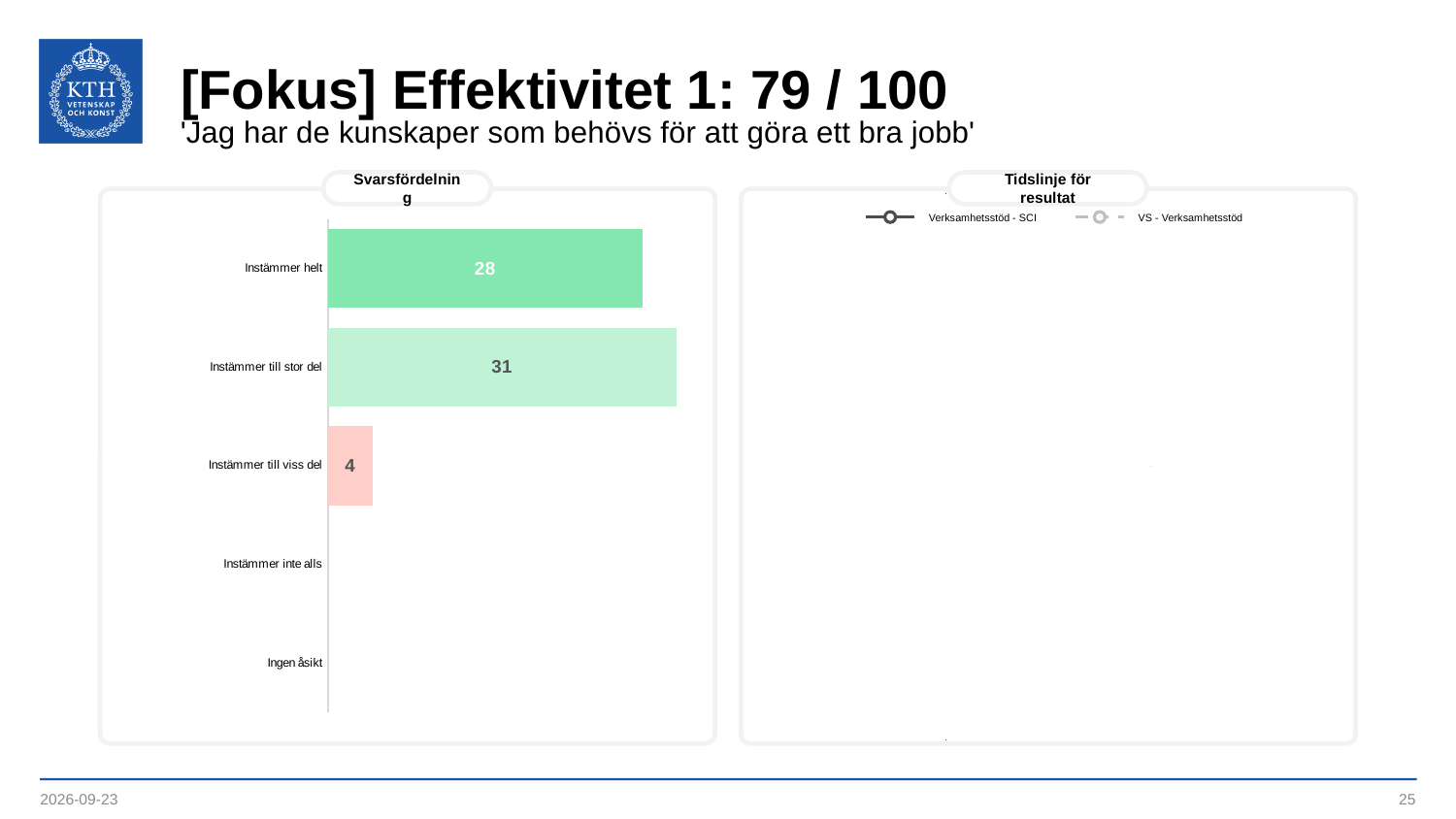
In the 'Svarsfördelning' chart, what is the difference between 'Instämmer helt' and 'Instämmer till viss del'? 24 In the 'Svarsfördelning' chart, what is the value for 'Instämmer till stor del'? 31 In the 'Svarsfördelning' chart, which of the labelled bars has the lowest value? Instämmer till viss del In the 'Svarsfördelning' chart, which is larger: 'Instämmer helt' or 'Instämmer till stor del'? Instämmer till stor del In the 'Svarsfördelning' chart, what is the difference between 'Instämmer till stor del' and 'Instämmer helt'? 3 What kind of chart is the 'Svarsfördelning' chart? Bar chart In the 'Svarsfördelning' chart, what is the value for 'Instämmer till viss del'? 4 What are the two legend entries in the 'Tidslinje för resultat' chart? Verksamhetsstöd - SCI and VS - Verksamhetsstöd How many series does the legend of the 'Tidslinje för resultat' chart list? 2 How many categories are listed on the axis of the 'Svarsfördelning' chart? 5 In the 'Svarsfördelning' chart, what is the value for 'Instämmer helt'? 28 In the 'Svarsfördelning' chart, which category has the highest value? Instämmer till stor del